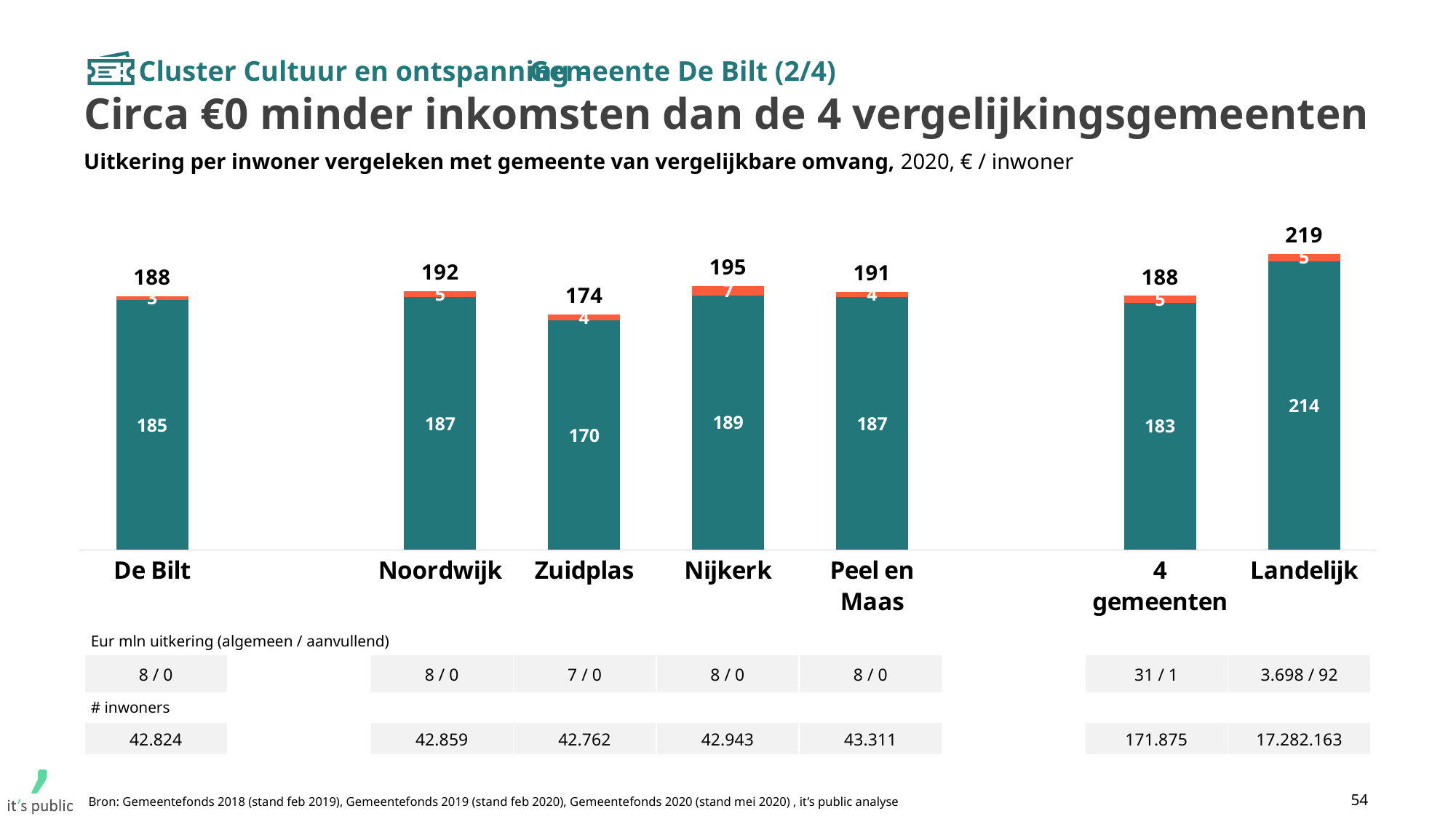
Which has a larger total value, Noordwijk or Peel en Maas? Noordwijk What is the value of the teal (lower) segment for 4 gemeenten? 183 What is the total value shown above the bar for Zuidplas? 174 What is the difference between the total for Nijkerk and the total for Zuidplas? 21 What is the value of the teal (lower) segment for Landelijk? 214 How many categories (bars) are shown in the chart? 7 What kind of chart is shown on the slide? Stacked bar chart Which category has the highest total value? Landelijk Which category has the lowest total value? Zuidplas What is the difference between the total for Landelijk and the total for De Bilt? 31 What is the total of the stacked bar for Peel en Maas? 191 What is the value of the orange (upper) segment for Nijkerk? 7